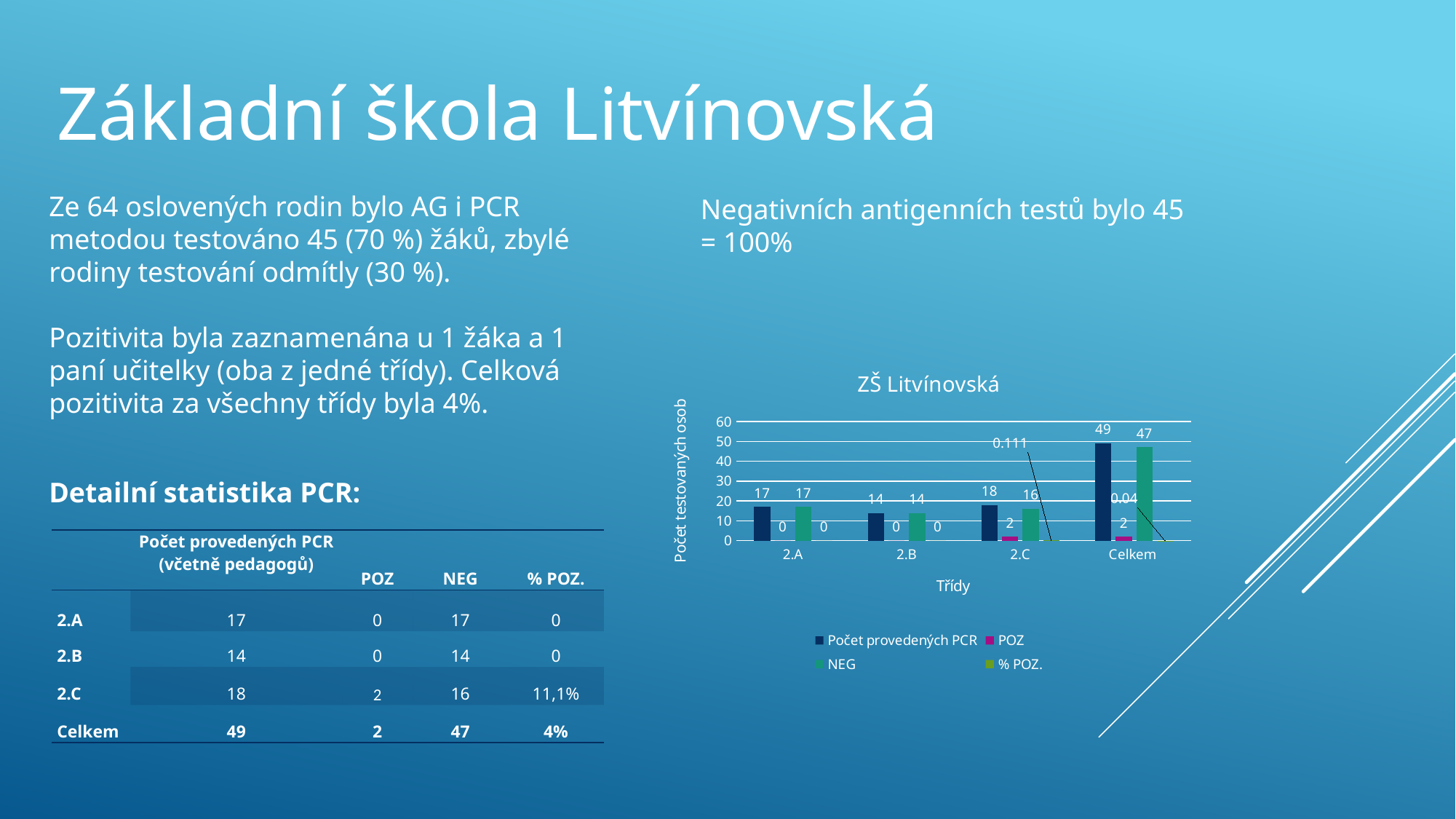
What is the % POZ. value labelled for 2.C in the chart? 0.111 How many series does the chart legend list? 4 How many categories are shown on the x axis of the chart? 4 Which category has the highest Počet provedených PCR value in the chart? Celkem What is the value of Počet provedených PCR for 2.C in the chart? 18 What is the difference between the Počet provedených PCR values for 2.C and 2.B in the chart? 4 Which category has the lowest Počet provedených PCR value in the chart? 2.B Is the NEG value for 2.A larger or smaller than the NEG value for 2.C in the chart? larger What is the title of the chart? ZŠ Litvínovská What type of chart is shown on the slide? bar chart What is the NEG value for Celkem in the chart? 47 What is the POZ value for 2.C in the chart? 2